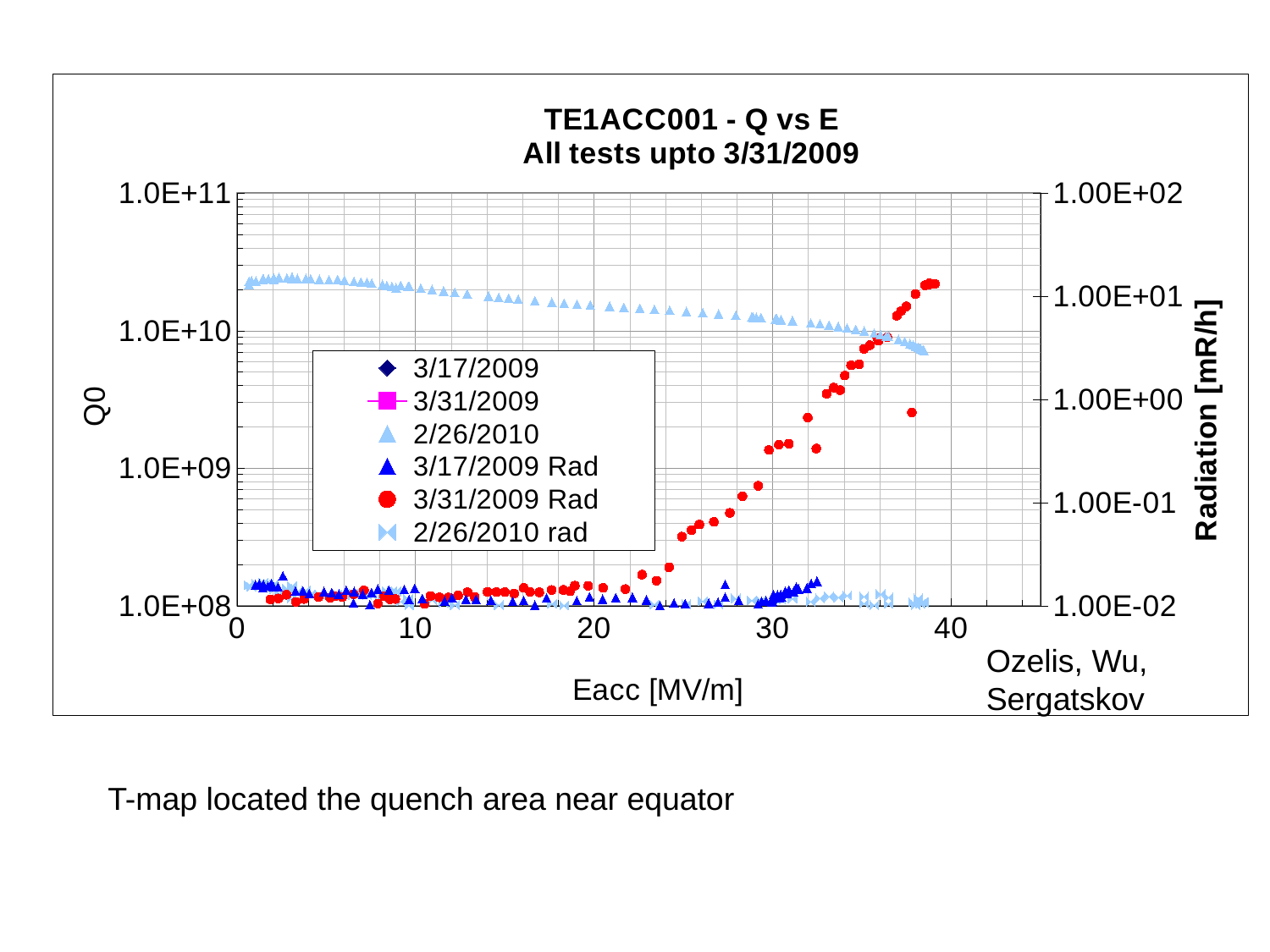
Which series reaches the highest radiation value on the chart? 3/31/2009 Rad Is the 3/31/2009 Rad value at Eacc = 10 MV/m greater or less than 1.00E-01 mR/h? less Is the 3/31/2009 Rad value at Eacc = 35 MV/m greater or less than 1.00E+00 mR/h? greater At Eacc = 30 MV/m, which series has the larger radiation value: 3/31/2009 Rad or 3/17/2009 Rad? 3/31/2009 Rad Does the Q0 of the 2/26/2010 series rise or fall as Eacc increases? fall How many series does the legend list? 6 What is the title of the chart? TE1ACC001 - Q vs E All tests upto 3/31/2009 What is the label of the right-hand vertical axis? Radiation [mR/h] Is the Q0 value of the 2/26/2010 series at Eacc = 10 MV/m greater or less than 1.0E+10? greater Does the 3/31/2009 Rad series rise or fall as Eacc increases beyond 20 MV/m? rise What kind of chart is shown on the slide? scatter chart What is the highest tick value shown on the Eacc axis? 40